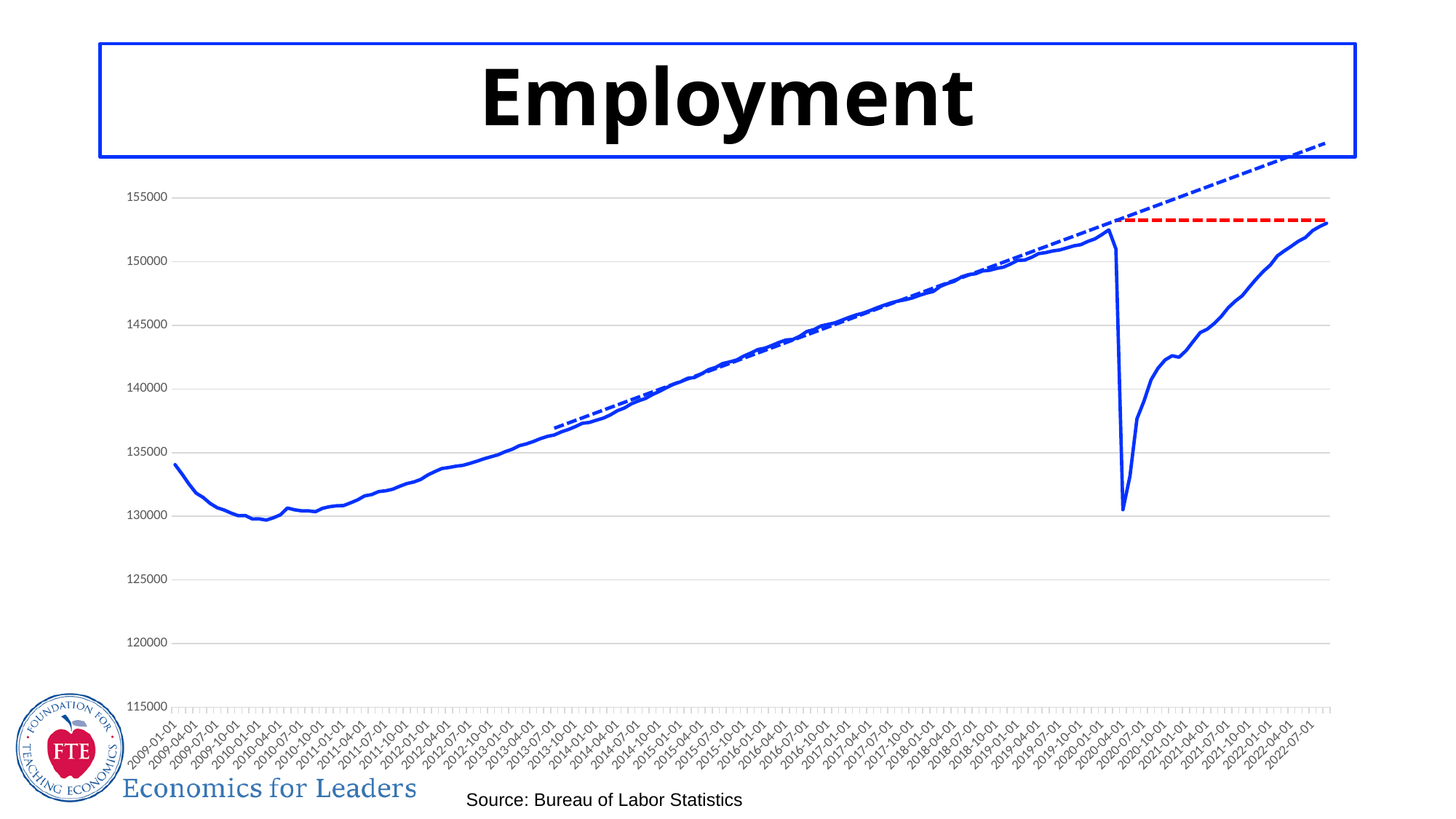
Is the value for 2020-04-01 greater or less than 135000? less Is the value for 2014-01-01 greater or less than 140000? less Is the value for 2009-01-01 greater or less than 135000? less What source is cited for the chart data? Bureau of Labor Statistics In which year does the lowest point on the line occur? 2010 Do the values generally rise or fall between 2010-01-01 and 2020-01-01? rise What is the title of the chart? Employment What kind of chart is shown on the slide? line chart Which is larger, the value for 2009-01-01 or the value for 2022-07-01? 2022-07-01